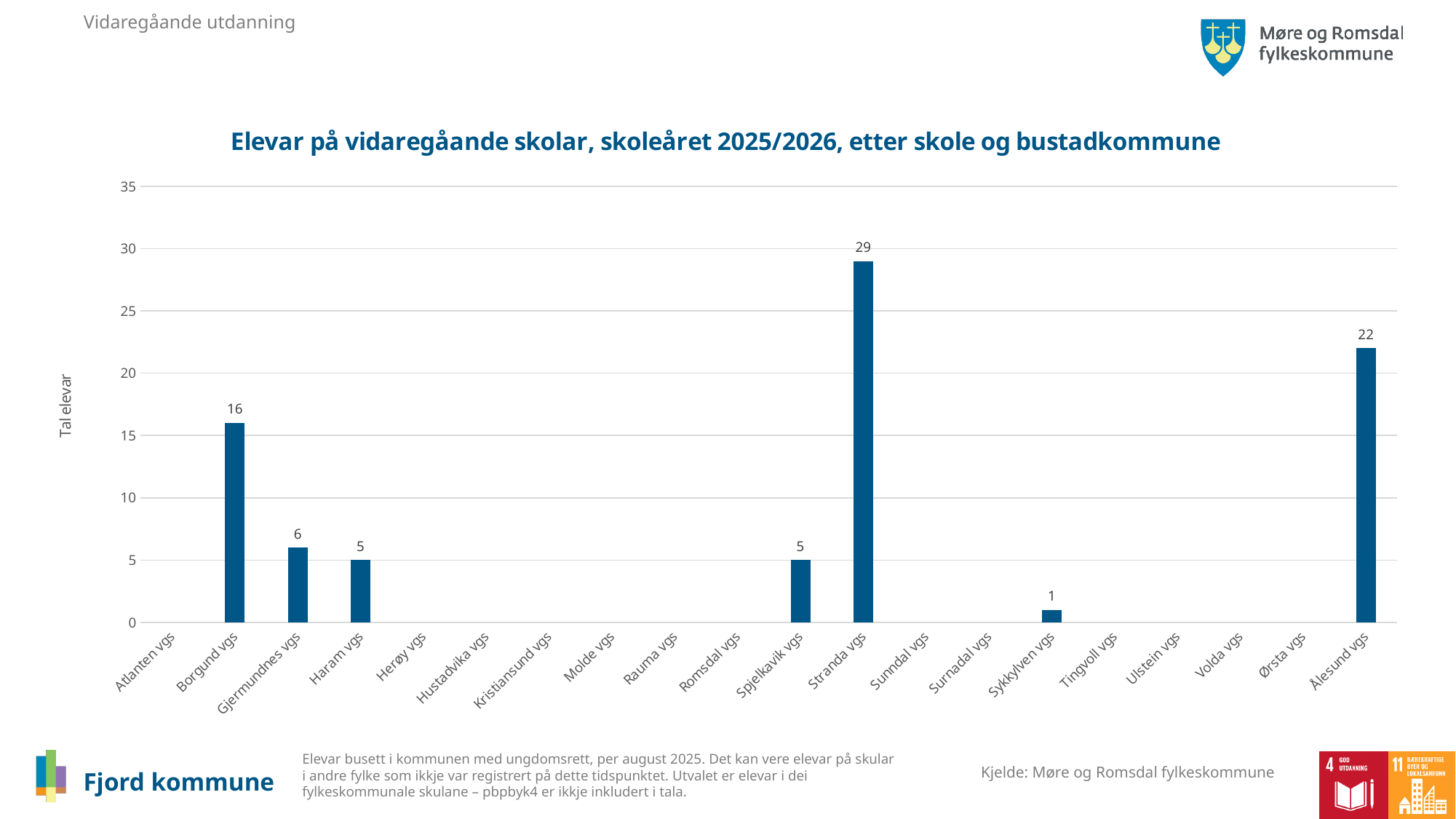
What is the value for Borgund vgs? 16 What is the difference between the values for Borgund vgs and Gjermundnes vgs? 10 What is the value for Sykkylven vgs? 1 What is the label of the y axis? Tal elevar What is the difference between the values for Stranda vgs and Ålesund vgs? 7 Among the schools with a labelled bar, which has the lowest value? Sykkylven vgs How many students are shown for Stranda vgs? 29 What is the value for Ålesund vgs? 22 Which school has the highest number of students? Stranda vgs Which is larger, the value for Borgund vgs or the value for Ålesund vgs? Ålesund vgs What kind of chart is shown on the slide? Bar chart How many schools are listed on the x axis? 20